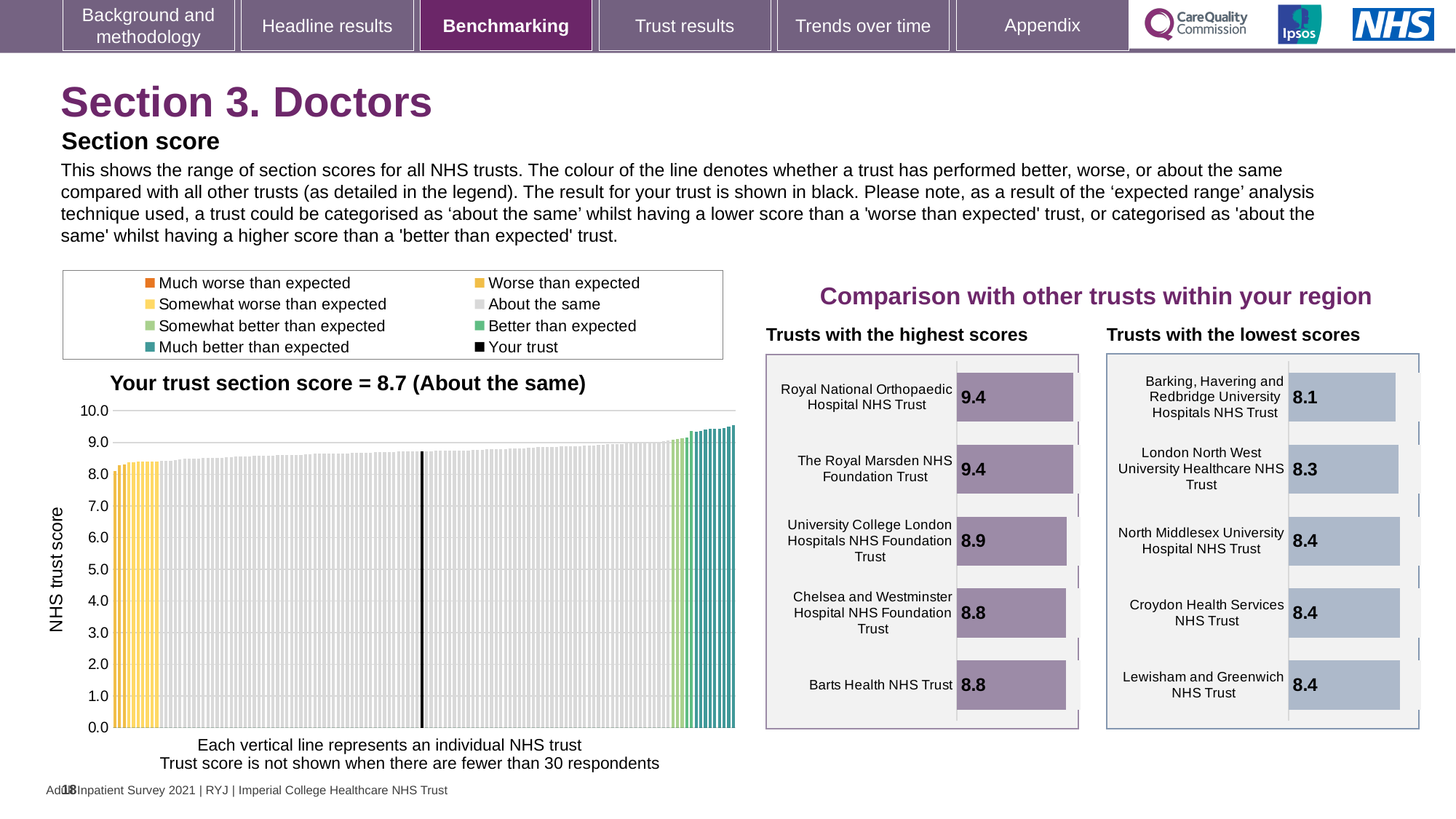
In the 'Trusts with the lowest scores' chart, what is the score for Barking, Havering and Redbridge University Hospitals NHS Trust? 8.1 In the 'Trusts with the highest scores' chart, which has the higher score: Chelsea and Westminster Hospital NHS Foundation Trust or University College London Hospitals NHS Foundation Trust? University College London Hospitals NHS Foundation Trust According to the large chart on the left, what is your trust's section score? 8.7 In the 'Trusts with the lowest scores' chart, what is the difference between the score for London North West University Healthcare NHS Trust and the score for Barking, Havering and Redbridge University Hospitals NHS Trust? 0.2 How many entries does the legend above the large chart on the left list? 8 In the 'Trusts with the lowest scores' chart, which trust has the lowest score? Barking, Havering and Redbridge University Hospitals NHS Trust How many trusts are listed in the 'Trusts with the highest scores' chart? 5 In the 'Trusts with the highest scores' chart, what is the score for University College London Hospitals NHS Foundation Trust? 8.9 How many trusts are listed in the 'Trusts with the lowest scores' chart? 5 In the large chart on the left showing all NHS trusts, do the scores rise or fall from left to right? Rise What kind of chart is the large chart on the left showing the range of section scores for all NHS trusts? Bar chart In the 'Trusts with the highest scores' chart, what is the difference between the score for Royal National Orthopaedic Hospital NHS Trust and the score for Barts Health NHS Trust? 0.6